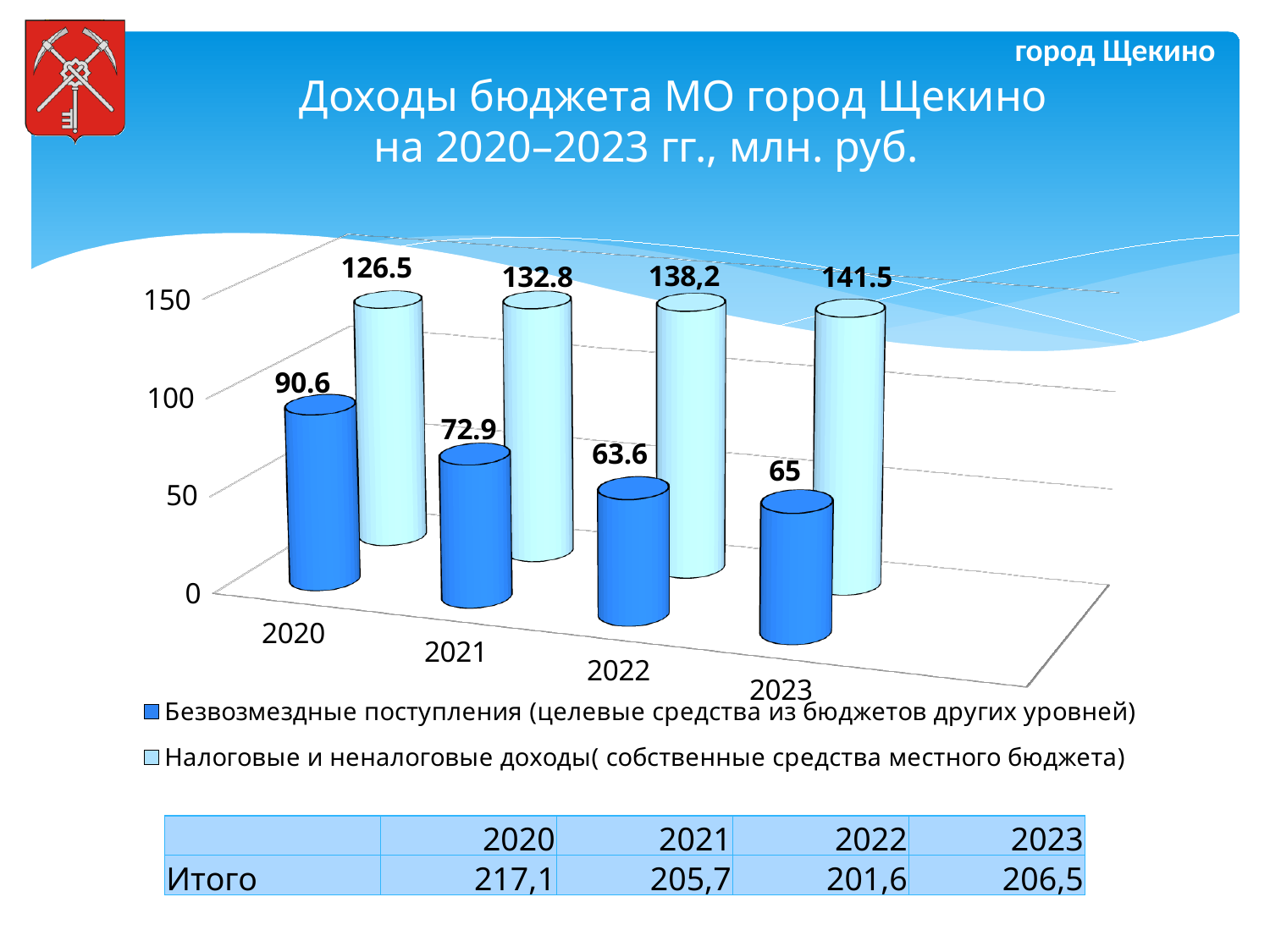
What kind of chart is shown on the slide? Bar chart What is the value of Безвозмездные поступления for 2023? 65 In which year is Налоговые и неналоговые доходы the lowest? 2020 Which is larger in 2022: Безвозмездные поступления or Налоговые и неналоговые доходы? Налоговые и неналоговые доходы What is the value of Налоговые и неналоговые доходы for 2022? 138,2 How many series does the legend list? 2 What is the difference between Налоговые и неналоговые доходы and Безвозмездные поступления in 2021? 59.9 What is the value of Налоговые и неналоговые доходы for 2023? 141.5 What is the value of Безвозмездные поступления for 2020? 90.6 How many years are shown on the x axis of the chart? 4 In which year is Безвозмездные поступления the highest? 2020 Do the values of Налоговые и неналоговые доходы rise or fall from 2020 to 2023? Rise